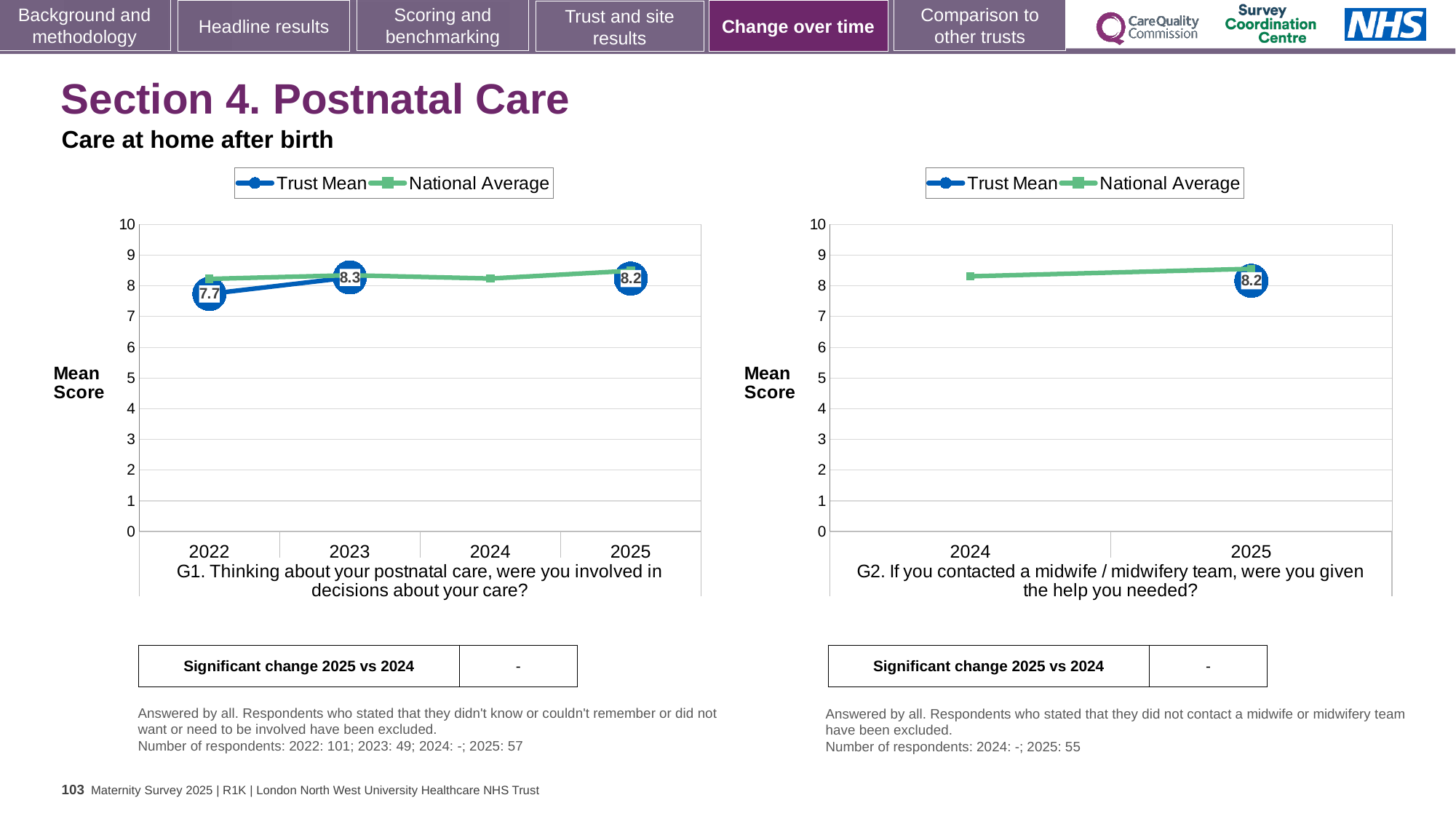
In the G1 chart on the left, which year has the lowest labelled Trust Mean score? 2022 In the G1 chart on the left, what is the Trust Mean score for 2023? 8.3 In the G1 chart on the left, is the Trust Mean score higher in 2022 or in 2023? 2023 In the G1 chart on the left, what is the Trust Mean score for 2022? 7.7 How many years are shown on the x axis of the G1 chart on the left? 4 How many series does the legend of the G2 chart on the right list? 2 In the G1 chart on the left, what is the Trust Mean score for 2025? 8.2 What kind of chart is the G2 chart on the right? Line chart In the G2 chart on the right, what is the Trust Mean score for 2025? 8.2 In the G1 chart on the left, which year has the highest labelled Trust Mean score? 2023 In the G1 chart on the left, is the National Average for 2024 greater or less than 7? greater In the G1 chart on the left, what is the difference between the Trust Mean scores for 2023 and 2022? 0.6